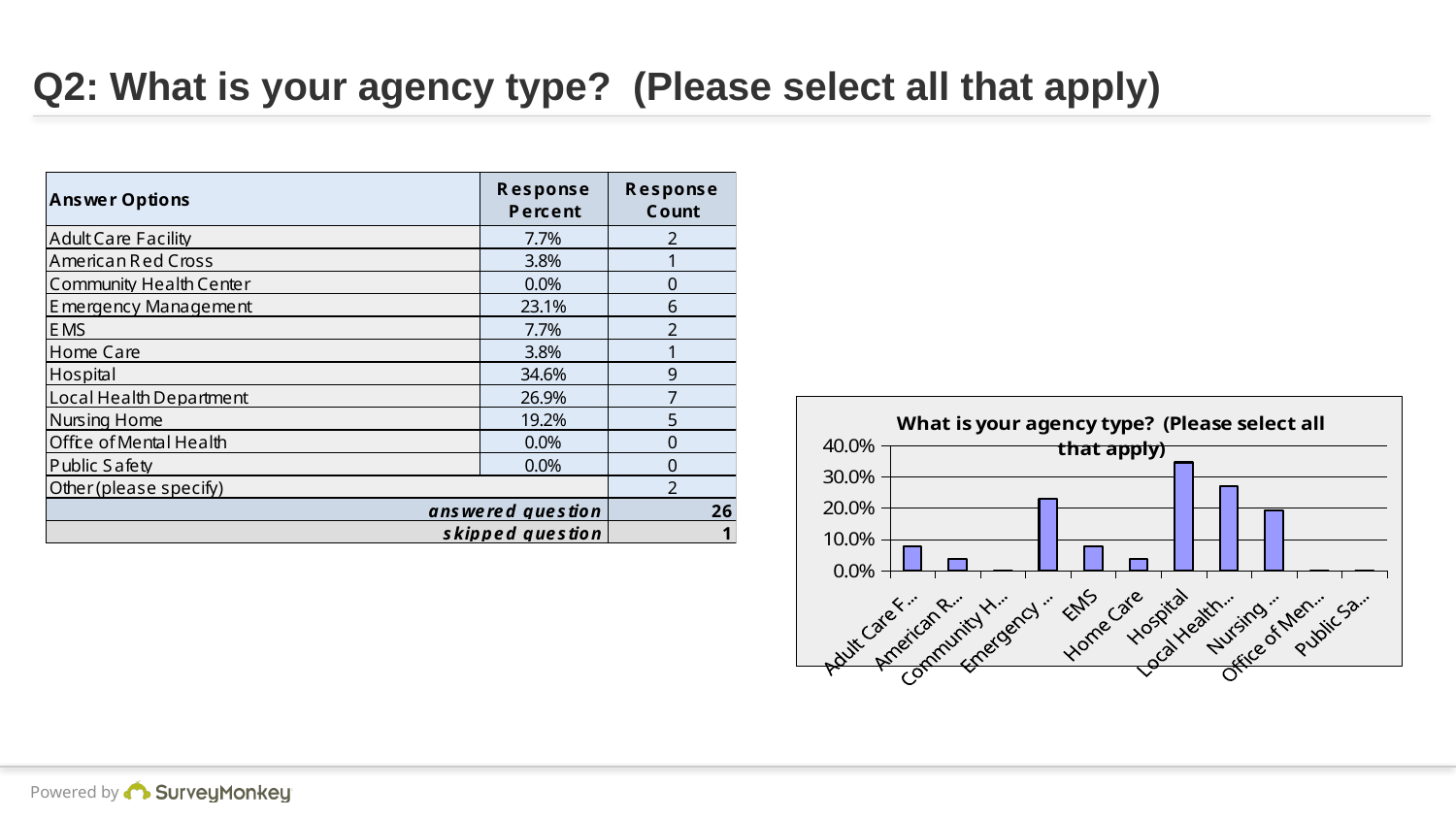
How many categories (bars) are plotted in the chart? 11 According to the table, what is the response percent for Hospital? 34.6% Is the value for EMS in the chart greater or less than 10.0%? less What is the highest value shown on the chart's vertical axis? 40.0% According to the table, what is the response count for Emergency Management? 6 According to the table, what is the difference in response percent between Hospital and Local Health Department? 7.7% Which category has the highest bar in the chart? Hospital What kind of chart is shown on the slide? bar chart Is the value for Hospital in the chart greater or less than 30.0%? greater Is the value for Emergency Management in the chart greater or less than 20.0%? greater What is the title of the chart? What is your agency type? (Please select all that apply) In the chart, which bar is taller: Local Health Department or Nursing Home? Local Health Department